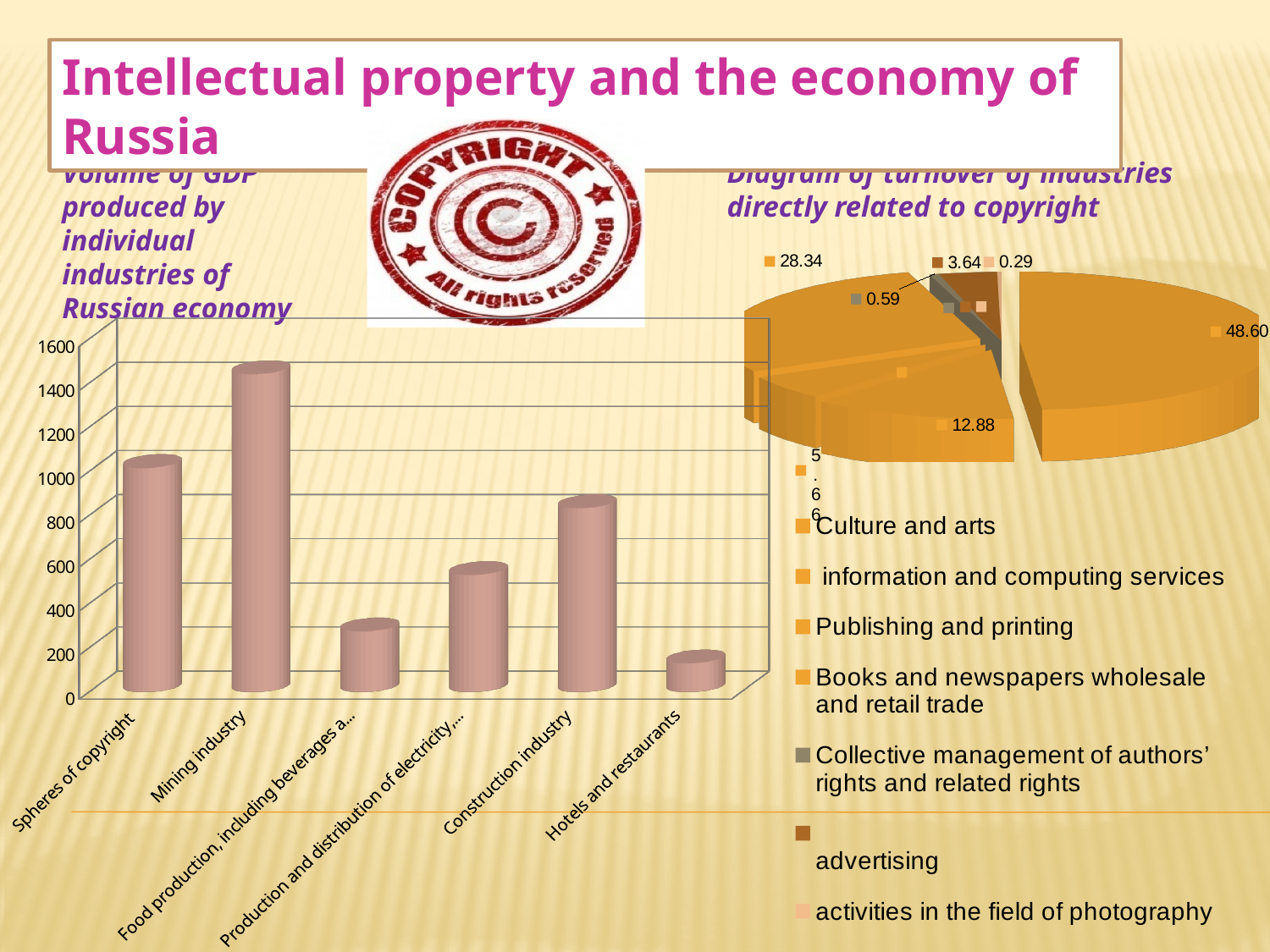
In the bar chart on the left, which industry has the lowest bar? Hotels and restaurants In the bar chart on the left, which industry has the highest bar? Mining industry In the pie chart on the right, what is the smallest value labelled on a slice? 0.29 In the pie chart on the right, how many entries does the legend list? 7 In the bar chart on the left, which is larger: the value for Construction industry or the value for Food production, including beverages? Construction industry What kind of chart is the chart on the left of the slide, titled 'Volume of GDP produced by individual industries of Russian economy'? bar chart In the bar chart on the left, is the value for Spheres of copyright greater or less than 800? greater In the pie chart on the right, what is the difference between the two largest labelled values, 48.60 and 28.34? 20.26 In the bar chart on the left, is the value for Hotels and restaurants greater or less than 400? less In the bar chart on the left, how many industry categories are shown on the x axis? 6 In the pie chart on the right, what is the largest value labelled on a slice? 48.60 What kind of chart is the chart on the right of the slide, titled 'Diagram of turnover of industries directly related to copyright'? pie chart